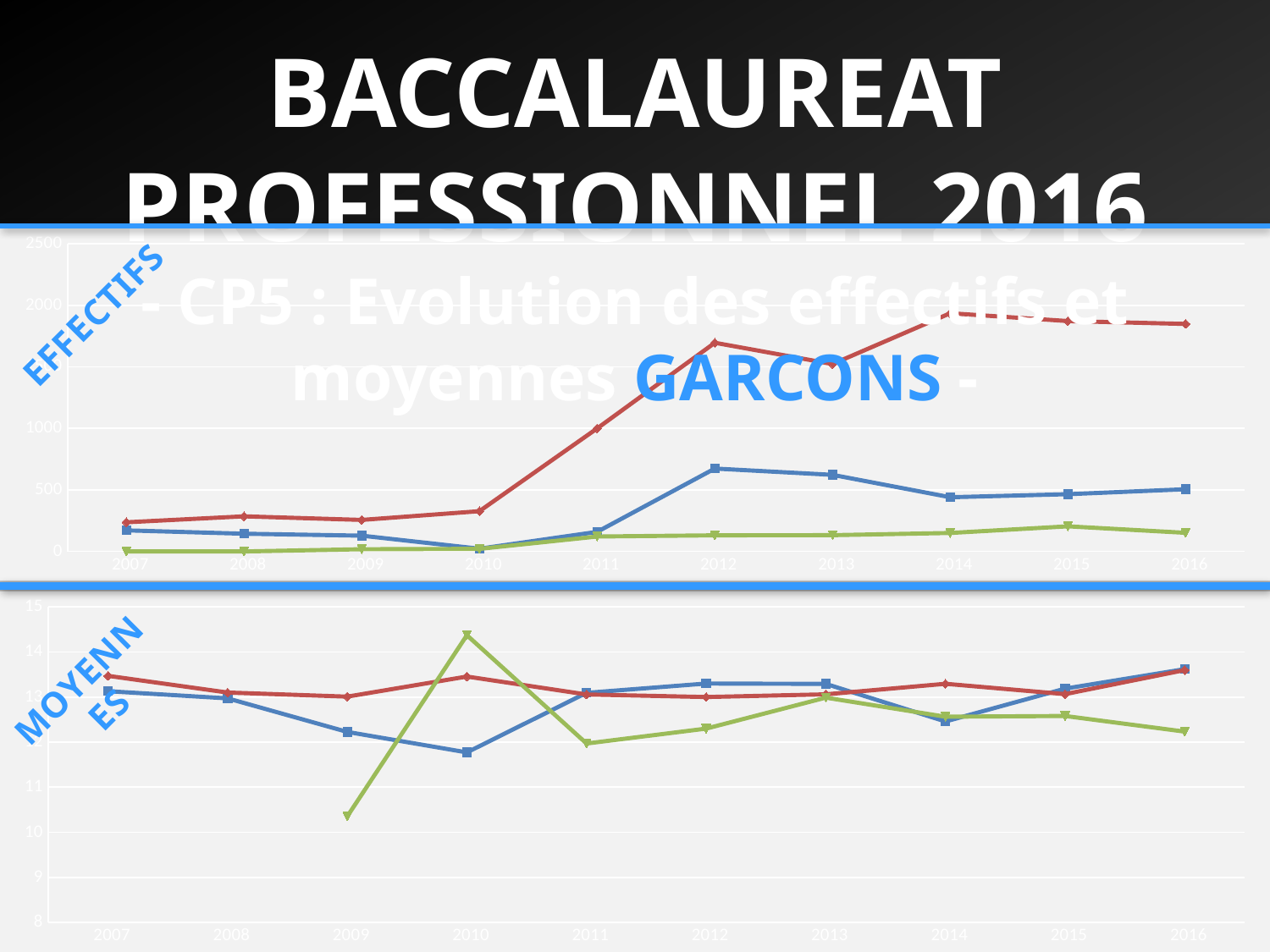
In the top chart (EFFECTIFS), how many years are shown on the x axis? 10 What is the label written beside the top chart? EFFECTIFS In the bottom chart (MOYENNES), in which year does the green line reach its lowest value? 2009 In the bottom chart (MOYENNES), in which year does the green line reach its highest value? 2010 What kind of chart is the top chart labelled EFFECTIFS? Line chart In the bottom chart (MOYENNES), is the value of the blue line in 2010 greater or less than 12? less In the top chart (EFFECTIFS), is the value of the green line in 2015 greater or less than 500? less In the top chart (EFFECTIFS), which line is higher in 2016, the red line or the blue line? The red line In the top chart (EFFECTIFS), does the red line rise or fall between 2010 and 2014? Rises In the top chart (EFFECTIFS), is the value of the red line in 2016 greater or less than 1500? greater What kind of chart is the bottom chart labelled MOYENNES? Line chart